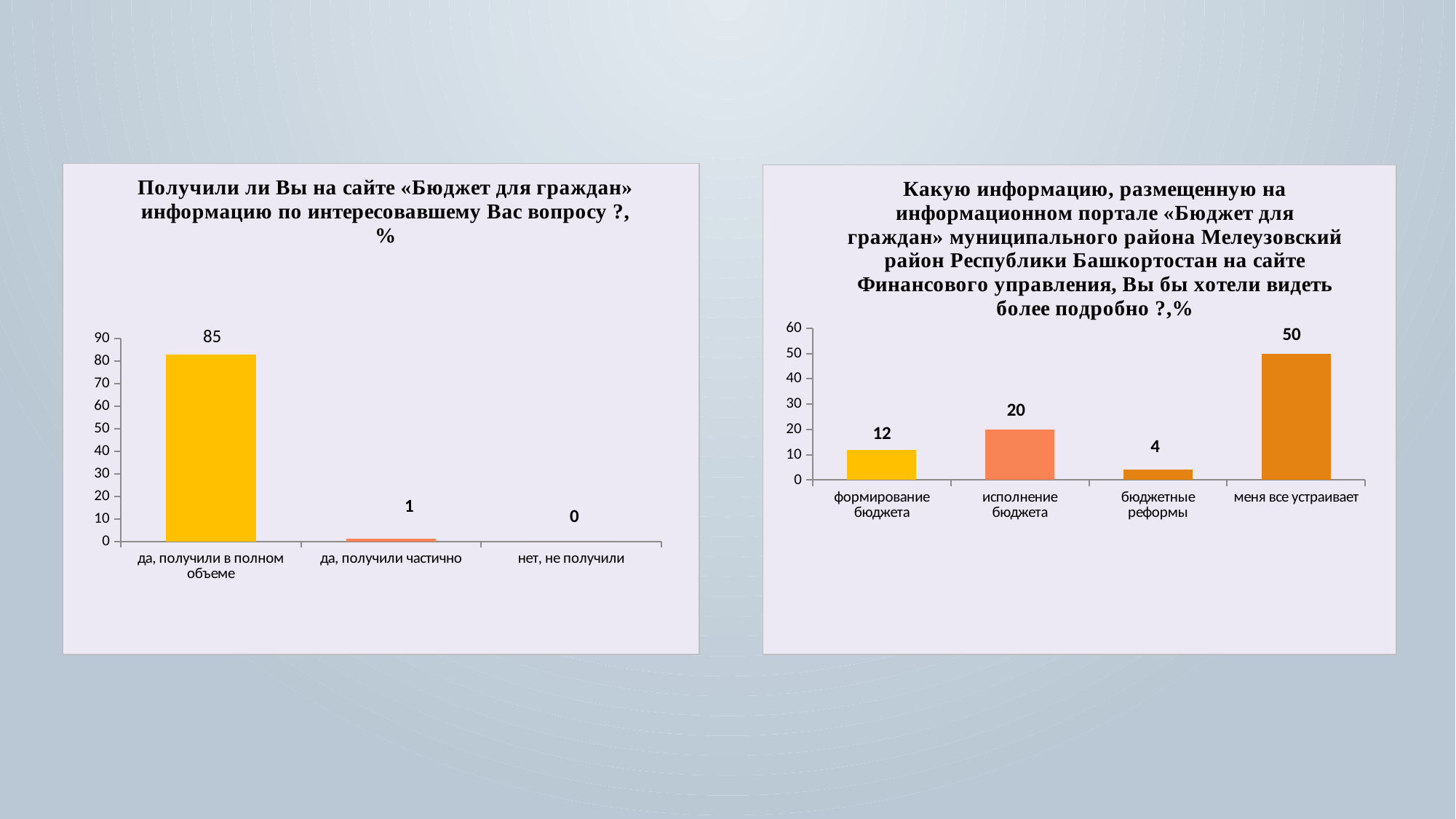
In the right chart, what is the value for "исполнение бюджета"? 20 In the left chart, what is the value for "да, получили частично"? 1 In the right chart, how many categories are shown on the x axis? 4 In the right chart, which is larger: the value for "формирование бюджета" or for "исполнение бюджета"? исполнение бюджета In the left chart, how many categories are shown on the x axis? 3 In the left chart, which category has the lowest value? нет, не получили In the right chart, what is the difference between the values for "меня все устраивает" and "формирование бюджета"? 38 In the right chart, which category has the highest value? меня все устраивает What kind of chart is the right chart? bar chart In the right chart, what is the value for "бюджетные реформы"? 4 In the left chart, what is the difference between the values for "да, получили в полном объеме" and "да, получили частично"? 84 In the left chart, what is the value for "да, получили в полном объеме"? 85